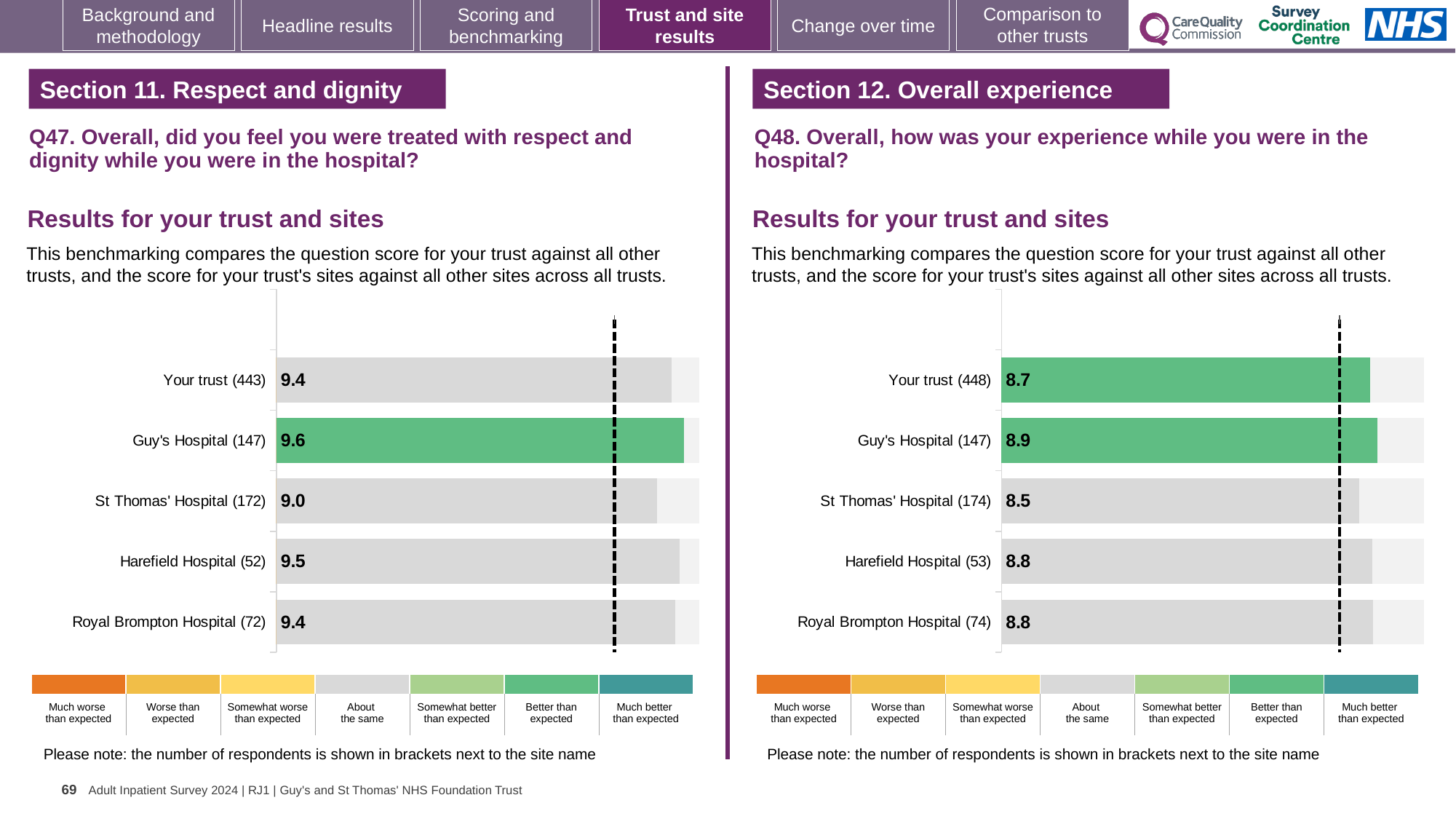
In the Q48 chart (right), what is the score for Your trust? 8.7 In the Q47 chart (left), which site or trust has the highest score? Guy's Hospital In the Q47 chart (left), what is the difference between the scores for Guy's Hospital and St Thomas' Hospital? 0.6 In the Q47 chart (left), what is the score for St Thomas' Hospital? 9.0 In the Q48 chart (right), what is the score for St Thomas' Hospital? 8.5 In the Q48 chart (right), which site or trust has the highest score? Guy's Hospital In the Q48 chart (right), which has the larger score, Guy's Hospital or Harefield Hospital? Guy's Hospital In the Q48 chart (right), which site or trust has the lowest score? St Thomas' Hospital What kind of chart is used for the Q47 results (left)? Bar chart In the Q47 chart (left), what is the score for Guy's Hospital? 9.6 How many bars are plotted in the Q48 chart (right)? 5 In the Q47 chart (left), which site or trust has the lowest score? St Thomas' Hospital